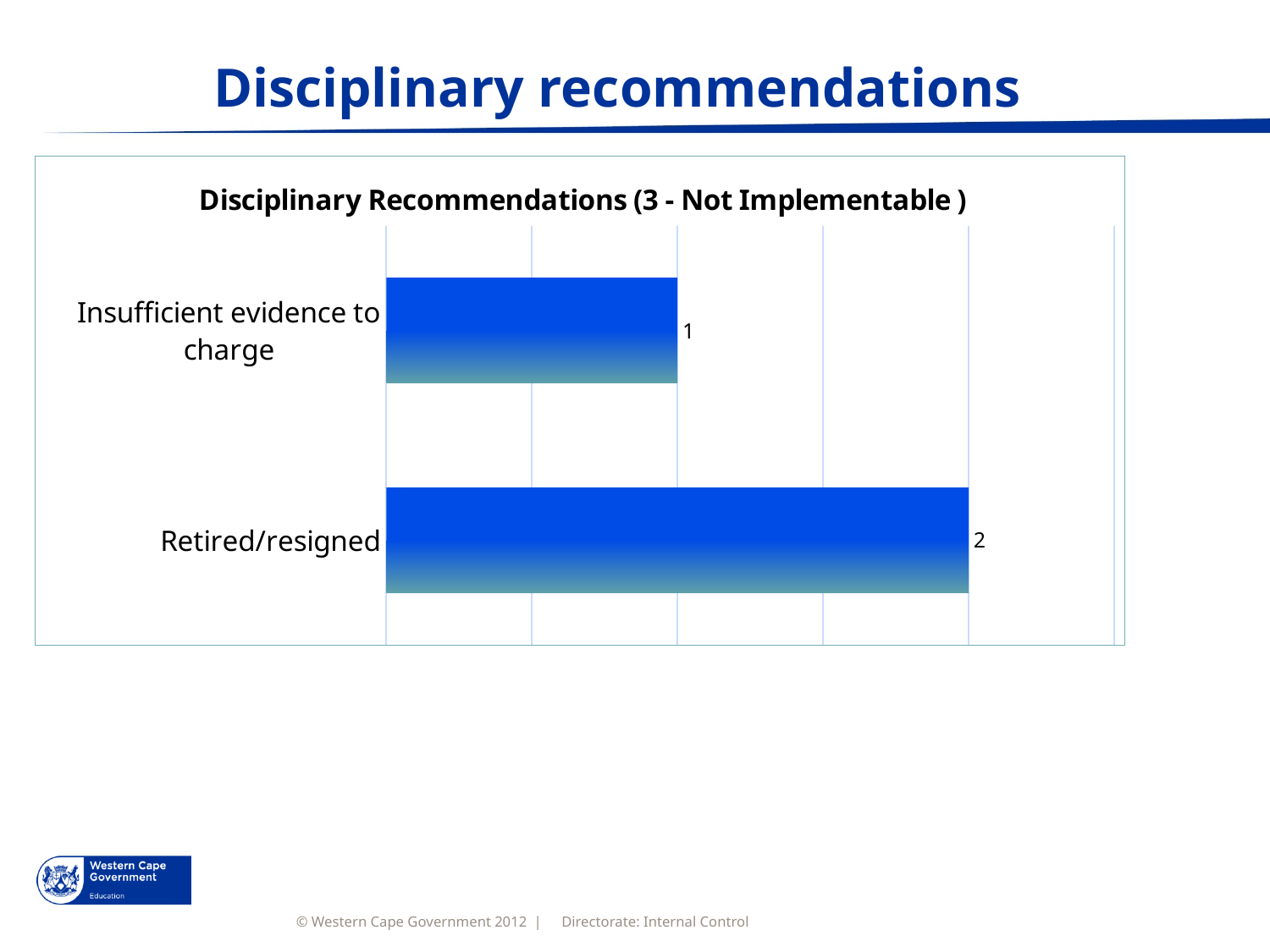
Which is larger, the value for Retired/resigned or the value for Insufficient evidence to charge? Retired/resigned What is the value for Insufficient evidence to charge? 1 What is the total of the values for the two categories shown? 3 What kind of chart is shown on the slide? Bar chart What is the difference between the values for Retired/resigned and Insufficient evidence to charge? 1 What is the title of the chart? Disciplinary Recommendations (3 - Not Implementable ) What is the value for Retired/resigned? 2 Which category has the highest value? Retired/resigned How many categories are shown in the chart? 2 Which category has the lowest value? Insufficient evidence to charge